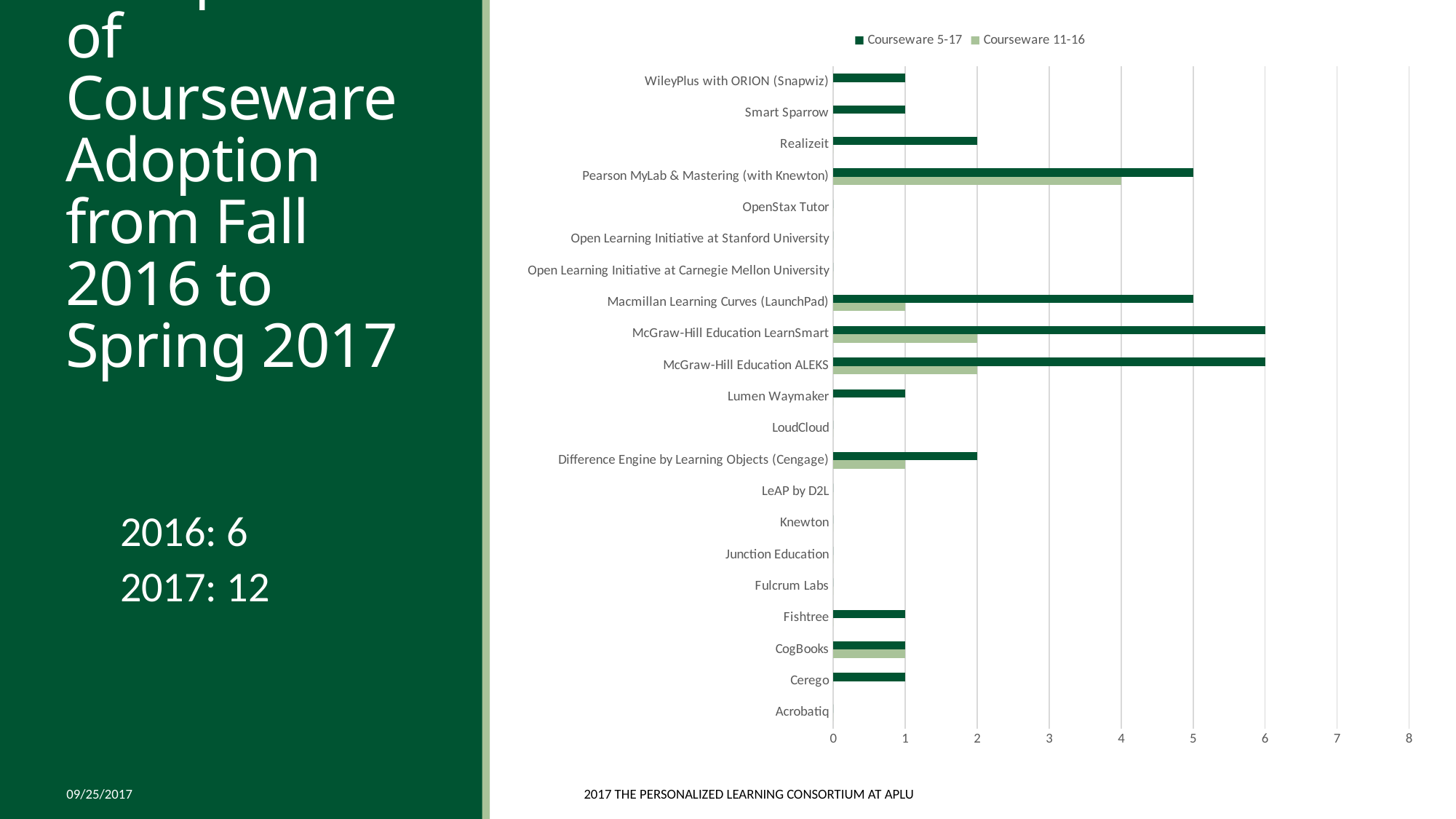
What is the difference between the Courseware 5-17 and Courseware 11-16 values for McGraw-Hill Education LearnSmart? 4 What is the Courseware 11-16 value for Macmillan Learning Curves (LaunchPad)? 1 What is the Courseware 5-17 value for Pearson MyLab & Mastering (with Knewton)? 5 What is the Courseware 11-16 value for Pearson MyLab & Mastering (with Knewton)? 4 What is the Courseware 5-17 value for McGraw-Hill Education ALEKS? 6 What are the two series named in the chart legend? Courseware 5-17 and Courseware 11-16 Which category has the highest Courseware 11-16 value? Pearson MyLab & Mastering (with Knewton) How many courseware products are listed as categories on the chart? 21 Which is larger for Realizeit: the Courseware 5-17 value or the Courseware 11-16 value? Courseware 5-17 Is the Courseware 5-17 value for Macmillan Learning Curves (LaunchPad) greater or less than 3? greater How many series does the chart legend list? 2 What kind of chart is shown on the slide? bar chart